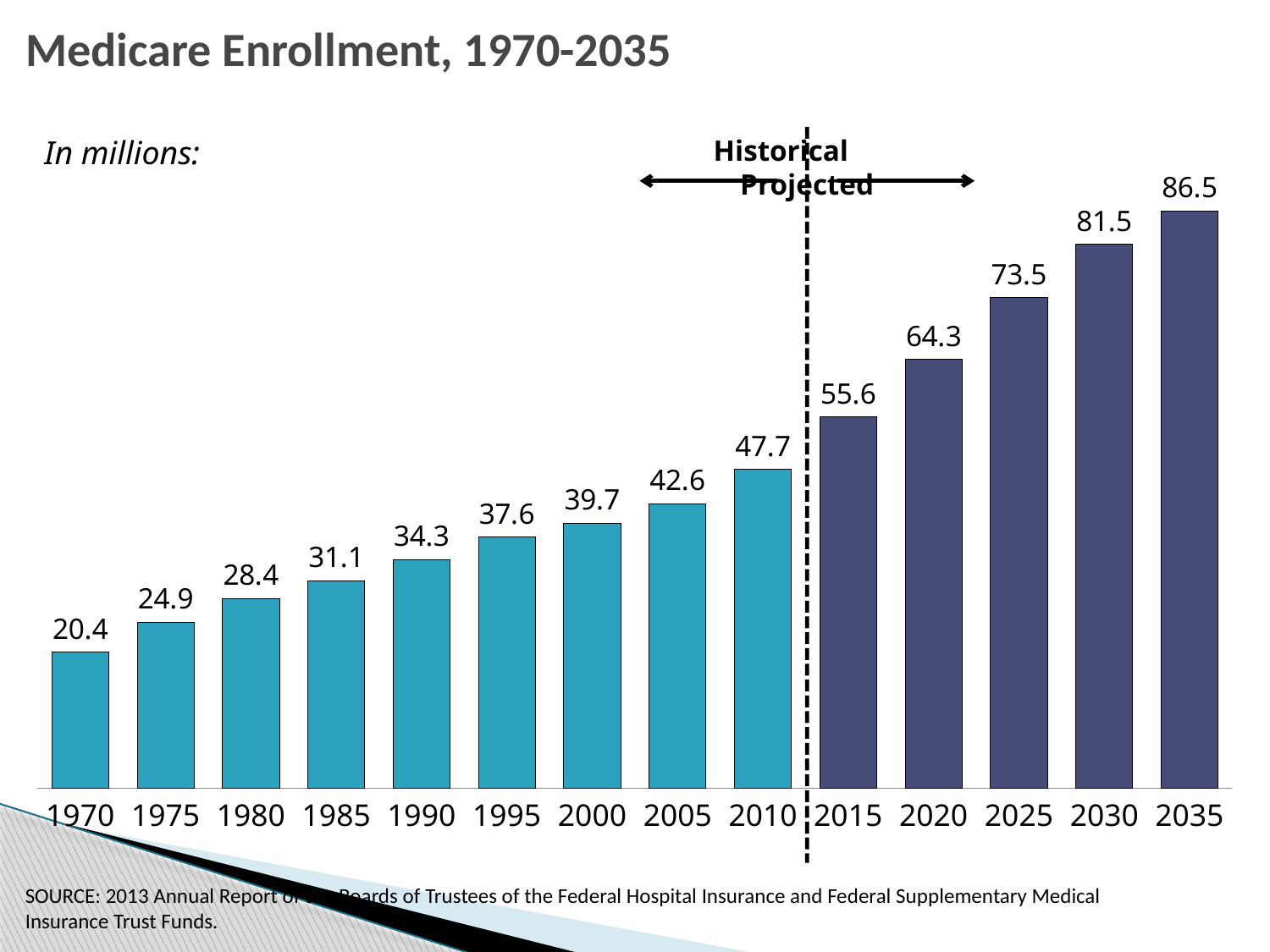
What is the Medicare enrollment value shown for 1990? 34.3 Which year has the highest Medicare enrollment on the chart? 2035 What is the title of the chart? Medicare Enrollment, 1970-2035 What is the Medicare enrollment value shown for 2020? 64.3 Which year has a larger enrollment value, 2005 or 2015? 2015 What is the difference between the enrollment values for 2000 and 1980? 11.3 Which year has the lowest Medicare enrollment on the chart? 1970 What is the difference between the enrollment values for 2035 and 2010? 38.8 How many years are shown on the x axis of the chart? 14 What kind of chart is shown on the slide? Bar chart What is the Medicare enrollment value shown for 1970? 20.4 Do the enrollment values rise or fall from 1970 to 2035? Rise